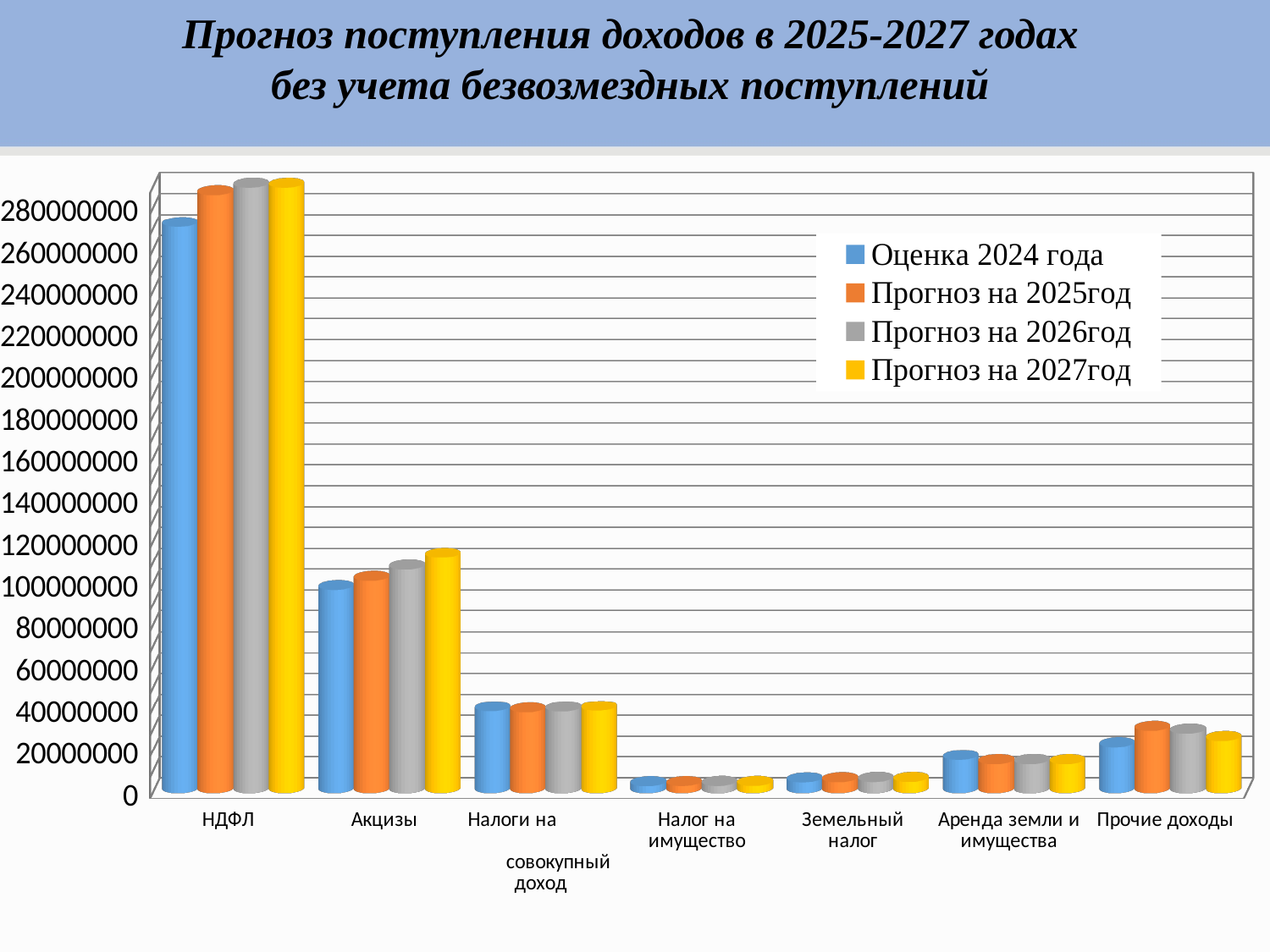
Is the value for Налоги на совокупный доход in the series Оценка 2024 года greater or less than 60000000? less Do the values for НДФЛ rise or fall from Оценка 2024 года to Прогноз на 2027год? rise Is the value for Налог на имущество in the series Прогноз на 2025год greater or less than 20000000? less Is the value for Прочие доходы in the series Прогноз на 2025год greater or less than 20000000? greater Which is larger for the series Прогноз на 2026год: НДФЛ or Акцизы? НДФЛ How many series does the chart legend list? 4 How many categories are shown on the x axis of the chart? 7 What is the title of the chart on the slide? Прогноз поступления доходов в 2025-2027 годах без учета безвозмездных поступлений Which category has the highest values in the chart? НДФЛ What kind of chart is shown on the slide? bar chart